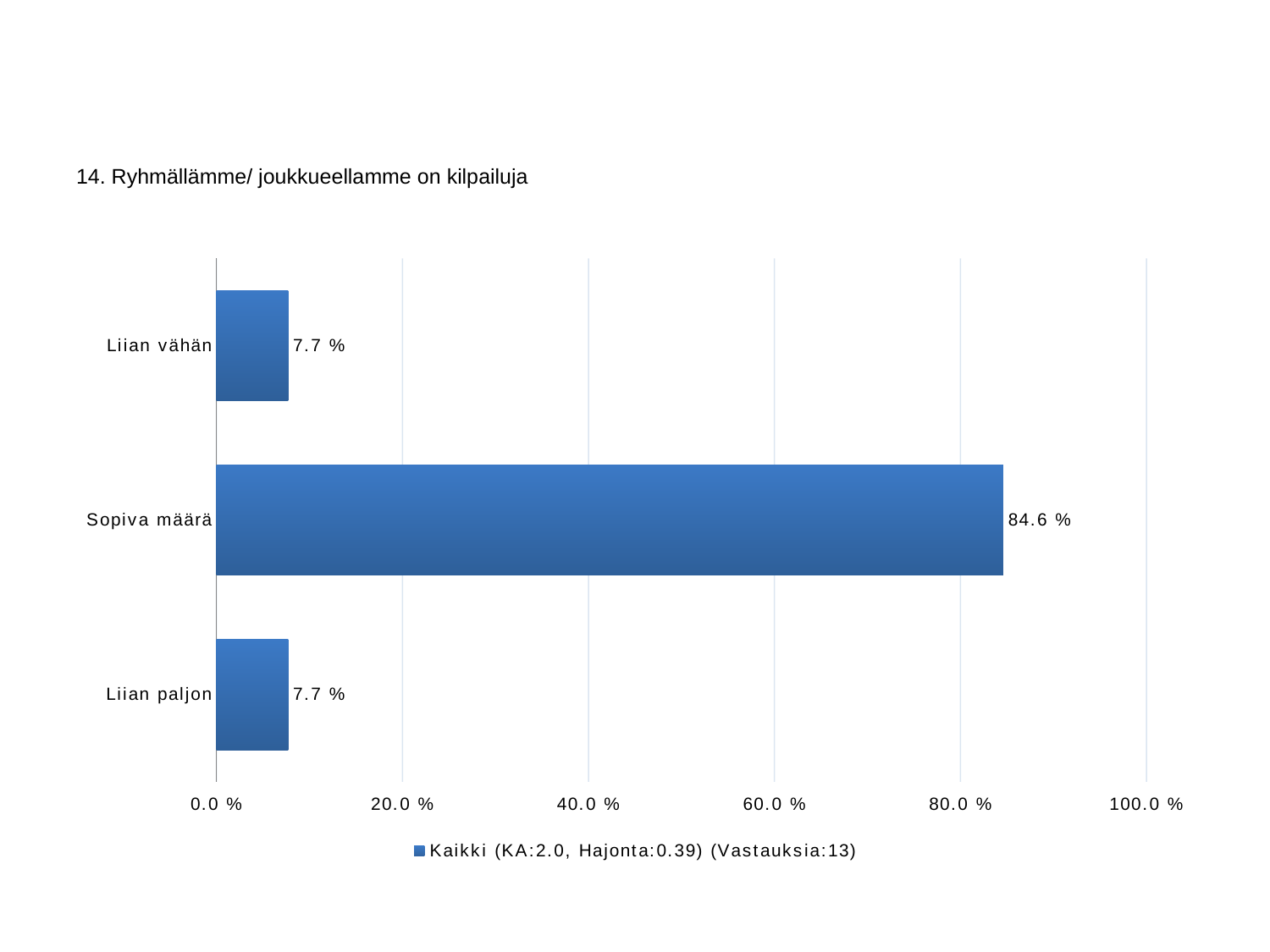
Is the value for Liian paljon greater or less than 20.0 %? less Which is larger, the value for Sopiva määrä or the value for Liian paljon? Sopiva määrä Is the value for Sopiva määrä greater or less than 80.0 %? greater What is the title of the chart? 14. Ryhmällämme/ joukkueellamme on kilpailuja How many categories are shown in the chart? 3 What is the value for Liian paljon? 7.7 % What is the value for Sopiva määrä? 84.6 % What is the difference between the values for Sopiva määrä and Liian vähän? 76.9 % Which category has the highest value? Sopiva määrä How many series does the legend list? 1 What is the value for Liian vähän? 7.7 % What kind of chart is shown on the slide? Bar chart